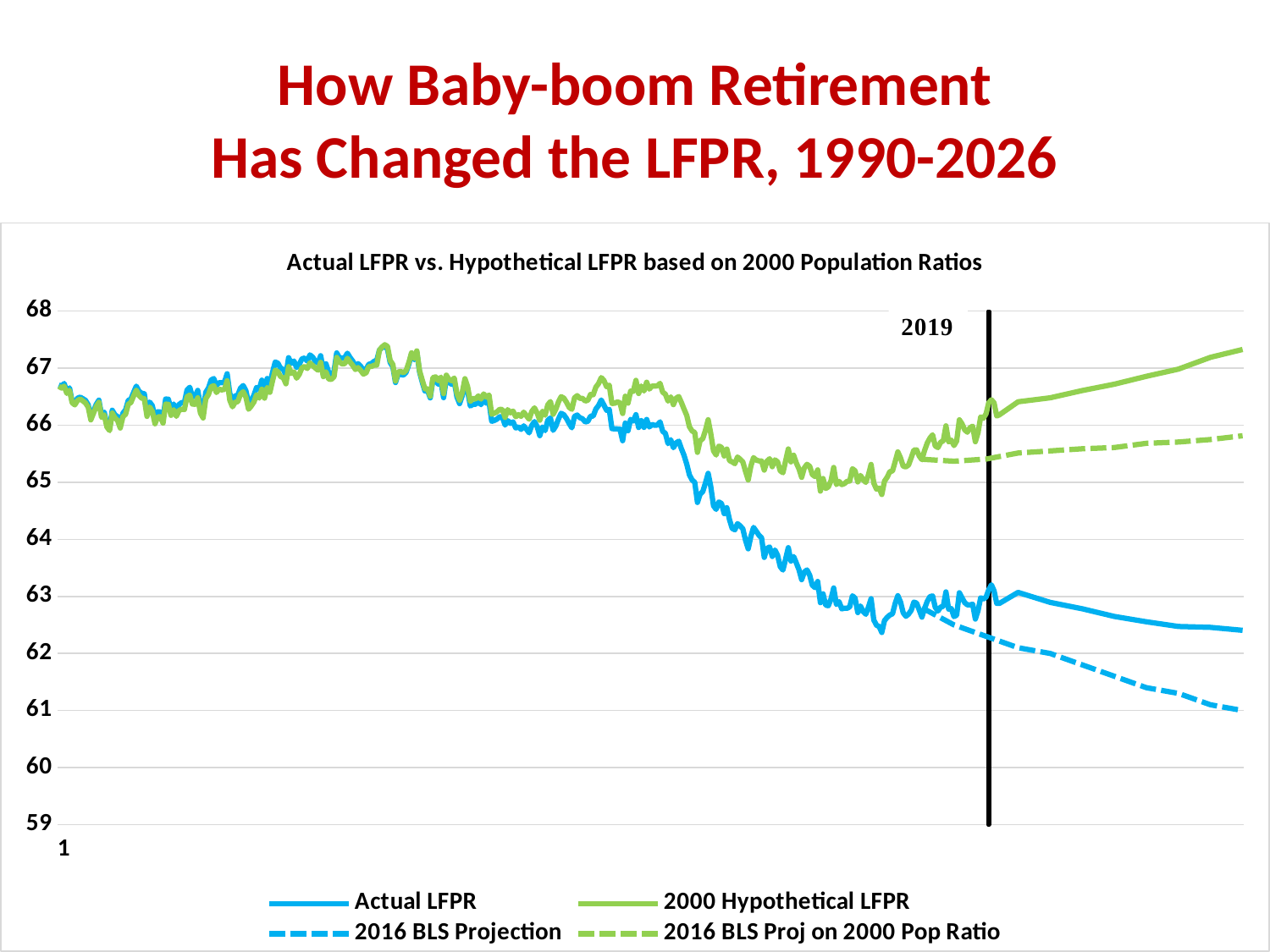
What is the title of the chart? Actual LFPR vs. Hypothetical LFPR based on 2000 Population Ratios After the 2019 line, does the 2000 Hypothetical LFPR line rise or fall? rise Does the Actual LFPR line overall rise or fall from the left of the chart to the right? fall Is the value of the Actual LFPR line at the right end of the chart greater or less than 63? less Is the value of the 2016 BLS Proj on 2000 Pop Ratio line at the right end of the chart greater or less than 65? greater At the right end of the chart, which is higher: the Actual LFPR line or the 2000 Hypothetical LFPR line? 2000 Hypothetical LFPR Is the value of the 2000 Hypothetical LFPR line at the right end of the chart greater or less than 67? greater How many series does the chart legend list? 4 What kind of chart is shown on the slide? line chart What year is labelled at the vertical black line on the chart? 2019 Which series is lowest at the right end of the chart? 2016 BLS Projection